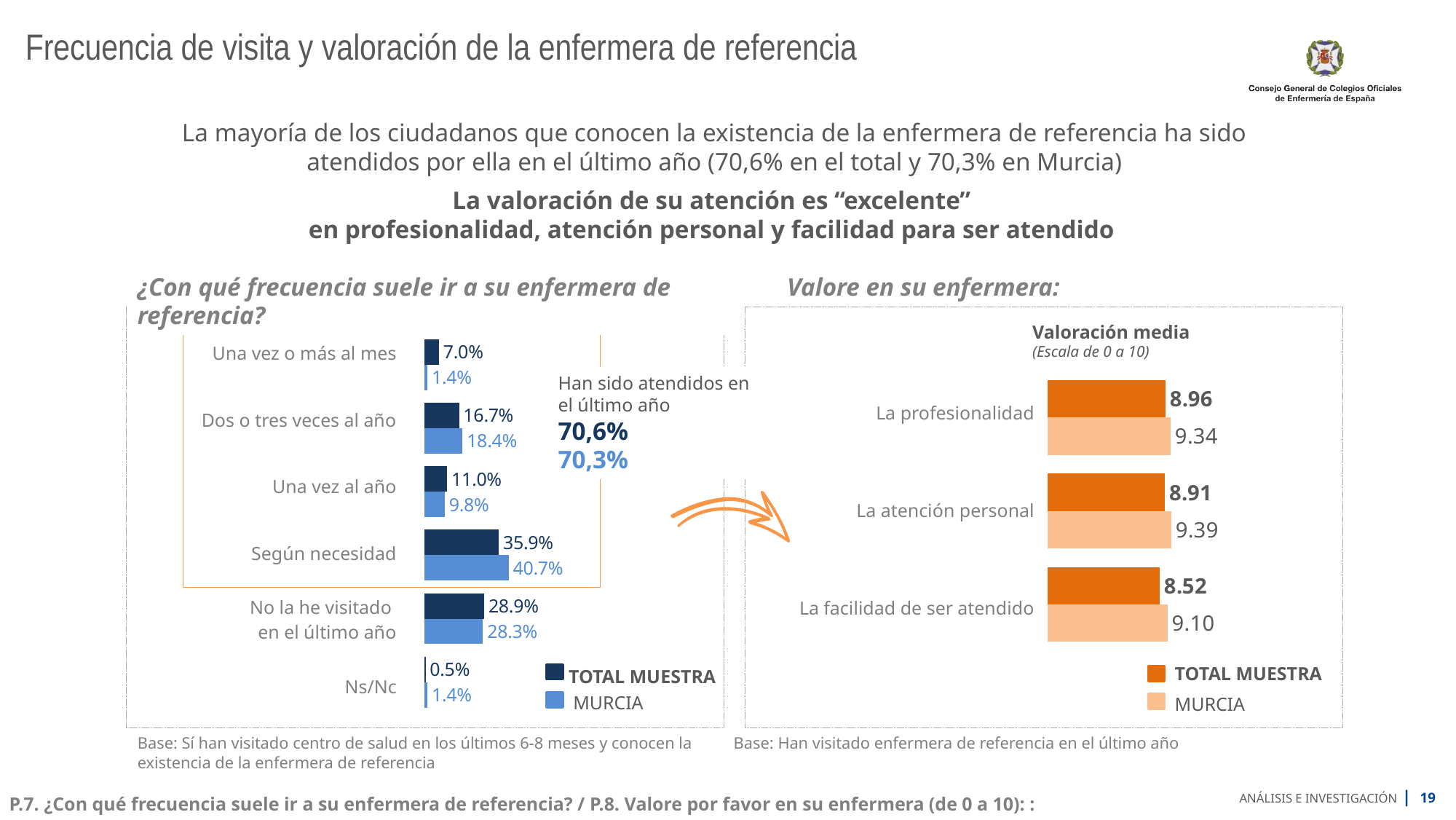
In the left chart (¿Con qué frecuencia suele ir a su enfermera de referencia?), what is the MURCIA value for 'Dos o tres veces al año'? 18.4% In the right chart (Valore en su enfermera), what is the TOTAL MUESTRA value for 'La facilidad de ser atendido'? 8.52 How many categories are shown in the left chart (¿Con qué frecuencia suele ir a su enfermera de referencia?)? 6 In the right chart (Valore en su enfermera), what is the MURCIA value for 'La atención personal'? 9.39 How many series does the legend of the right chart (Valore en su enfermera) list? 2 In the left chart (¿Con qué frecuencia suele ir a su enfermera de referencia?), what is the TOTAL MUESTRA value for 'Según necesidad'? 35.9% In the right chart (Valore en su enfermera), which category has the highest TOTAL MUESTRA value? La profesionalidad In the left chart (¿Con qué frecuencia suele ir a su enfermera de referencia?), which category has the lowest TOTAL MUESTRA value? Ns/Nc In the left chart (¿Con qué frecuencia suele ir a su enfermera de referencia?), which category has the highest MURCIA value? Según necesidad In the left chart (¿Con qué frecuencia suele ir a su enfermera de referencia?), which is larger for 'Una vez al año': TOTAL MUESTRA or MURCIA? TOTAL MUESTRA In the left chart (¿Con qué frecuencia suele ir a su enfermera de referencia?), what is the difference between the MURCIA and TOTAL MUESTRA values for 'Según necesidad'? 4.8% In the right chart (Valore en su enfermera), what is the difference between the MURCIA and TOTAL MUESTRA values for 'La profesionalidad'? 0.38